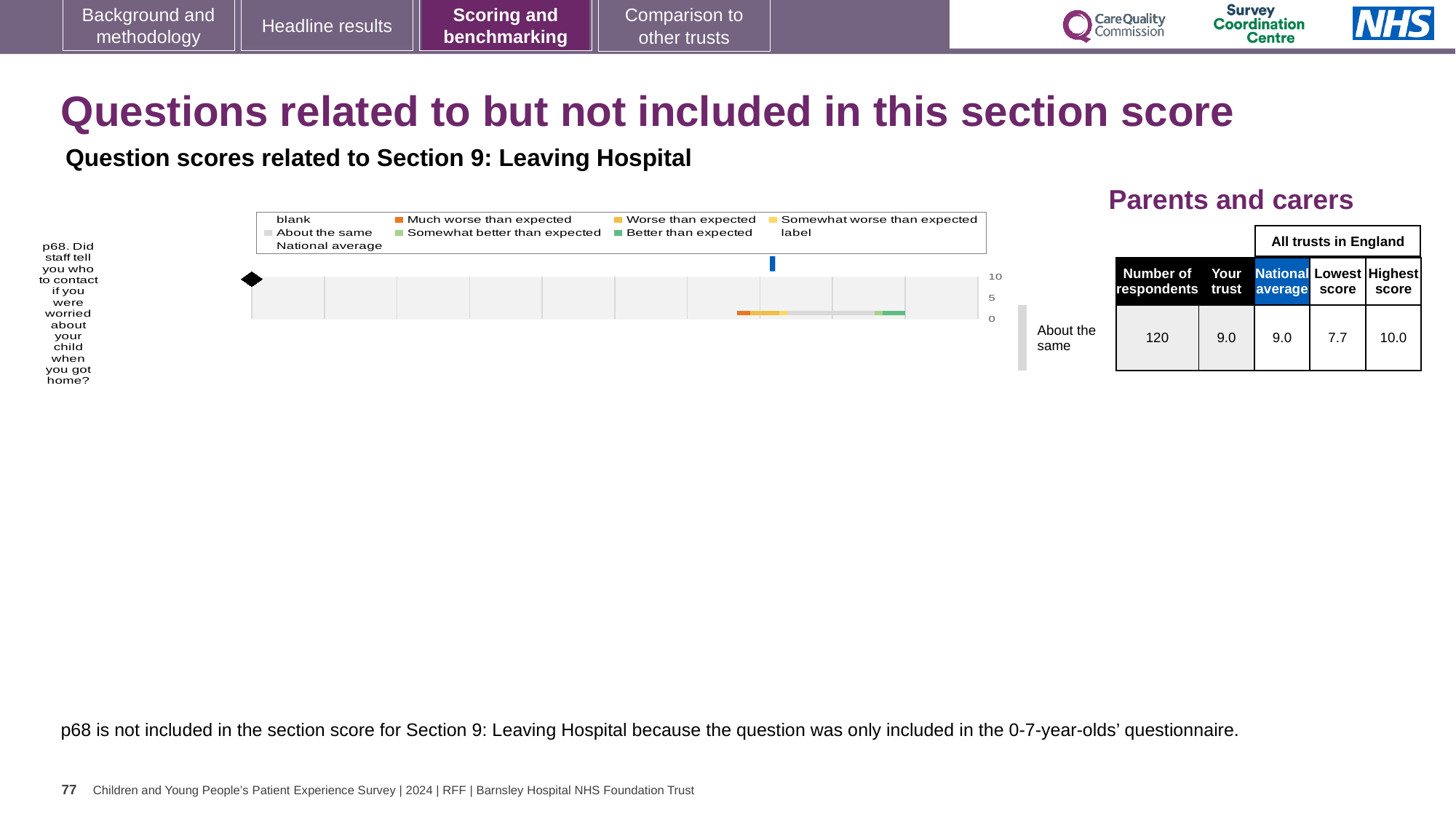
What is the highest value shown on the chart's axis? 10 What benchmark category label is shown next to the chart for p68? About the same Which is larger for p68: the Highest score or the Lowest score? Highest score What is the difference between the Highest score and the Lowest score for p68 in the table? 2.3 In the table, what is the Lowest score across all trusts in England for p68? 7.7 In the table, what is the National average score for p68? 9.0 Which question is plotted in the chart on the slide? p68. Did staff tell you who to contact if you were worried about your child when you got home? How many questions are plotted in the chart on the slide? 1 In the table, what is the Highest score across all trusts in England for p68? 10.0 In the table, how many respondents answered p68? 120 In the table, what is the 'Your trust' score for p68? 9.0 What kind of chart is shown on the slide for question p68? bar chart